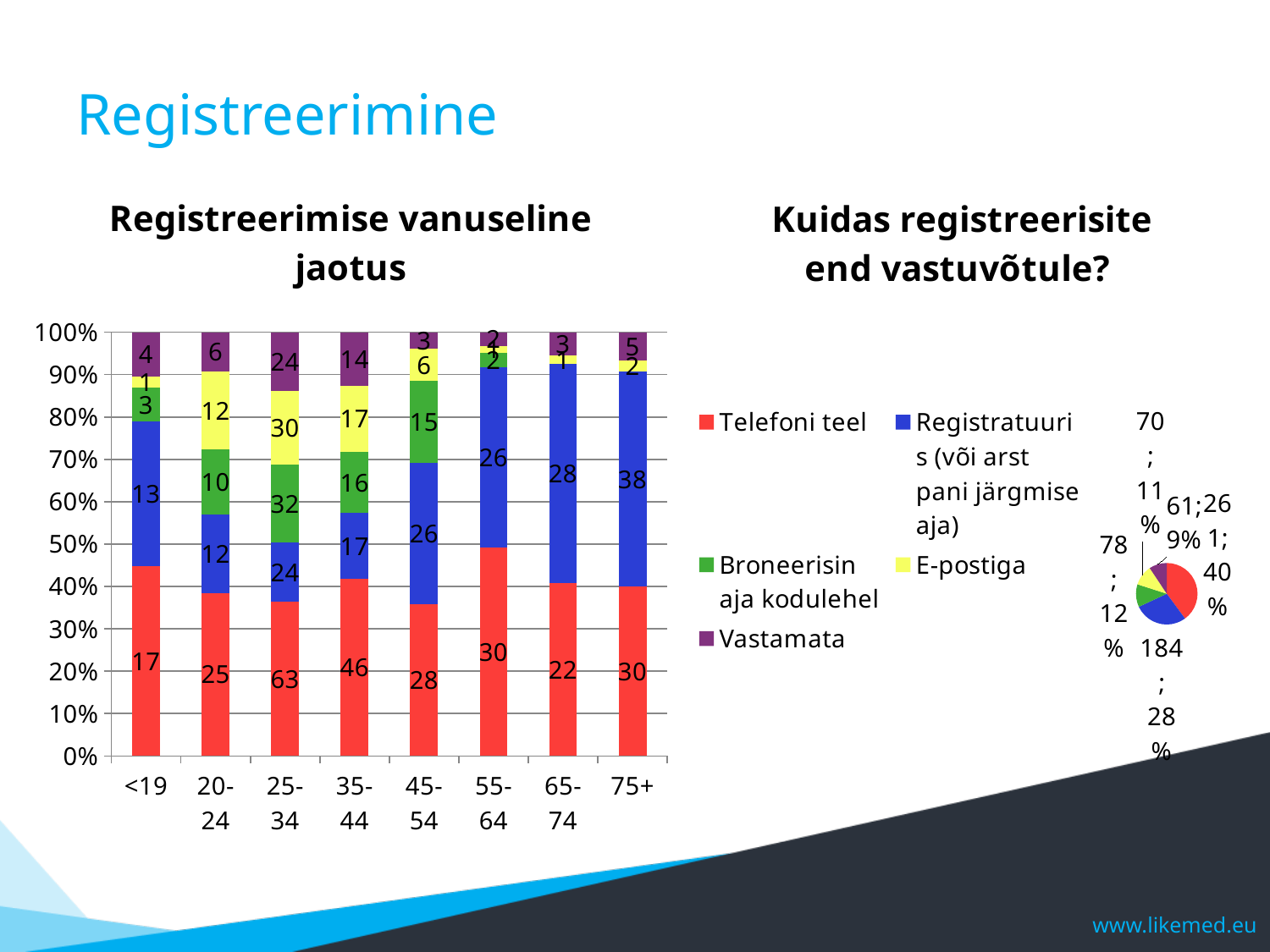
In the chart 'Registreerimise vanuseline jaotus', does the Telefoni teel segment for the <19 age group reach greater or less than 50% of the bar? less In the chart 'Registreerimise vanuseline jaotus', which age group has the highest value for Telefoni teel? 25-34 What kind of chart is 'Registreerimise vanuseline jaotus'? Stacked bar chart What kind of chart is 'Kuidas registreerisite end vastuvõtule?' on the right of the slide? Pie chart In the chart 'Registreerimise vanuseline jaotus', which is larger for Broneerisin aja kodulehel: the 25-34 group or the 35-44 group? 25-34 In the chart 'Registreerimise vanuseline jaotus', what is the difference between the Telefoni teel values for the 35-44 and 45-54 age groups? 18 In the chart 'Registreerimise vanuseline jaotus', what is the value for Vastamata in the 25-34 age group? 24 How many age groups are shown on the x axis of the chart 'Registreerimise vanuseline jaotus'? 8 In the chart 'Registreerimise vanuseline jaotus', what is the value for Registratuuris (või arst pani järgmise aja) in the 75+ age group? 38 In the chart 'Registreerimise vanuseline jaotus', what is the value for Telefoni teel in the 25-34 age group? 63 In the chart 'Registreerimise vanuseline jaotus', what is the value for E-postiga in the 20-24 age group? 12